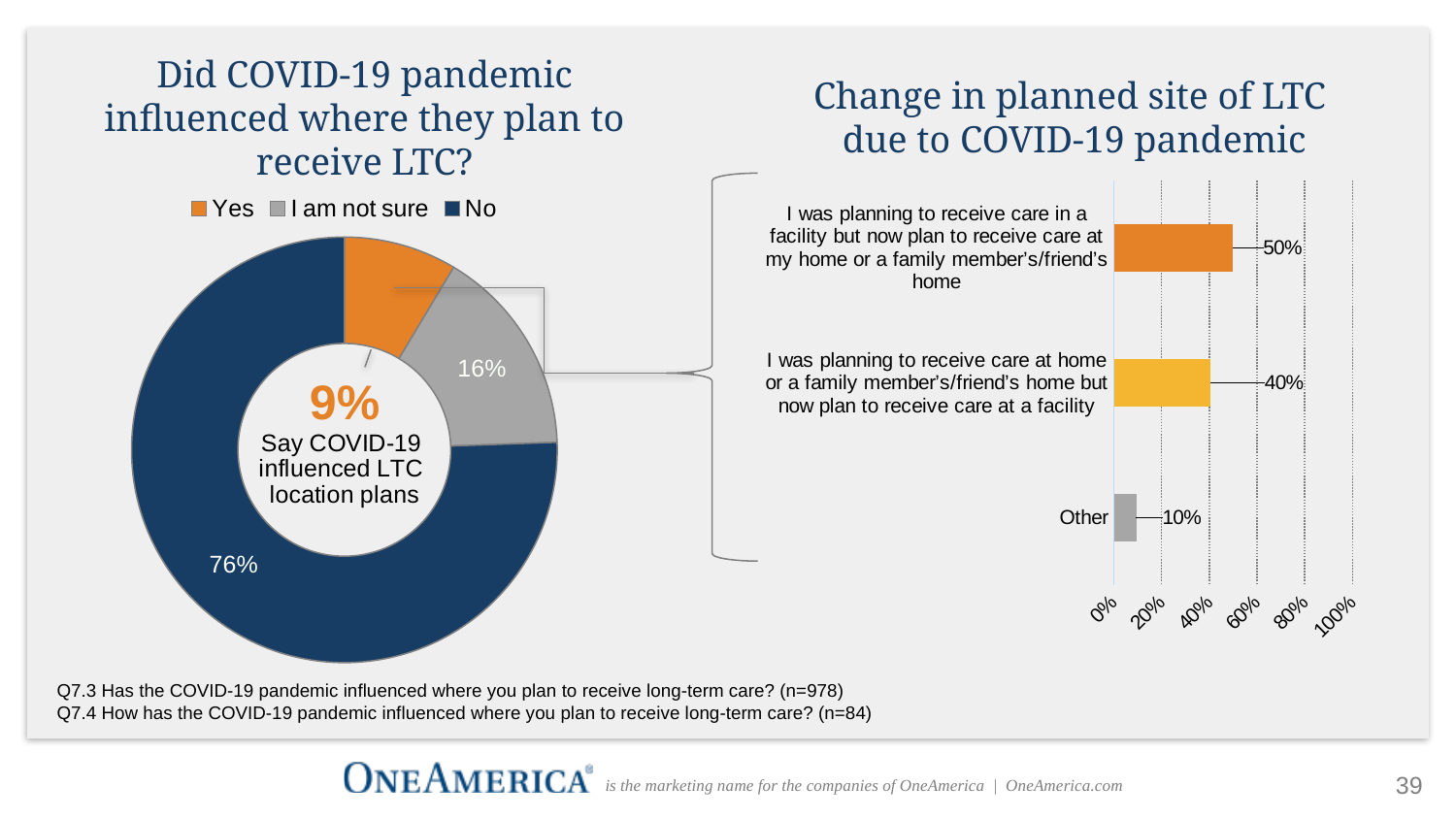
In the donut chart on the left, which response has the smallest share? Yes In the donut chart on the left, how many entries does the legend list? 3 In the chart titled "Change in planned site of LTC due to COVID-19 pandemic", how many categories are shown? 3 In the donut chart on the left, what percentage say COVID-19 influenced LTC location plans? 9% In the chart titled "Change in planned site of LTC due to COVID-19 pandemic", what is the value for those who were planning to receive care in a facility but now plan to receive care at home? 50% In the donut chart on the left, which response has the largest share? No In the donut chart on the left, what percentage answered "I am not sure"? 16% In the chart titled "Change in planned site of LTC due to COVID-19 pandemic", what is the value for "Other"? 10% In the donut chart on the left, what percentage answered "No"? 76% In the chart titled "Change in planned site of LTC due to COVID-19 pandemic", what is the value for those who were planning to receive care at home but now plan to receive care at a facility? 40% In the donut chart on the left, what is the difference in percentage points between "No" and "I am not sure"? 60 What kind of chart is the one titled "Change in planned site of LTC due to COVID-19 pandemic"? Bar chart